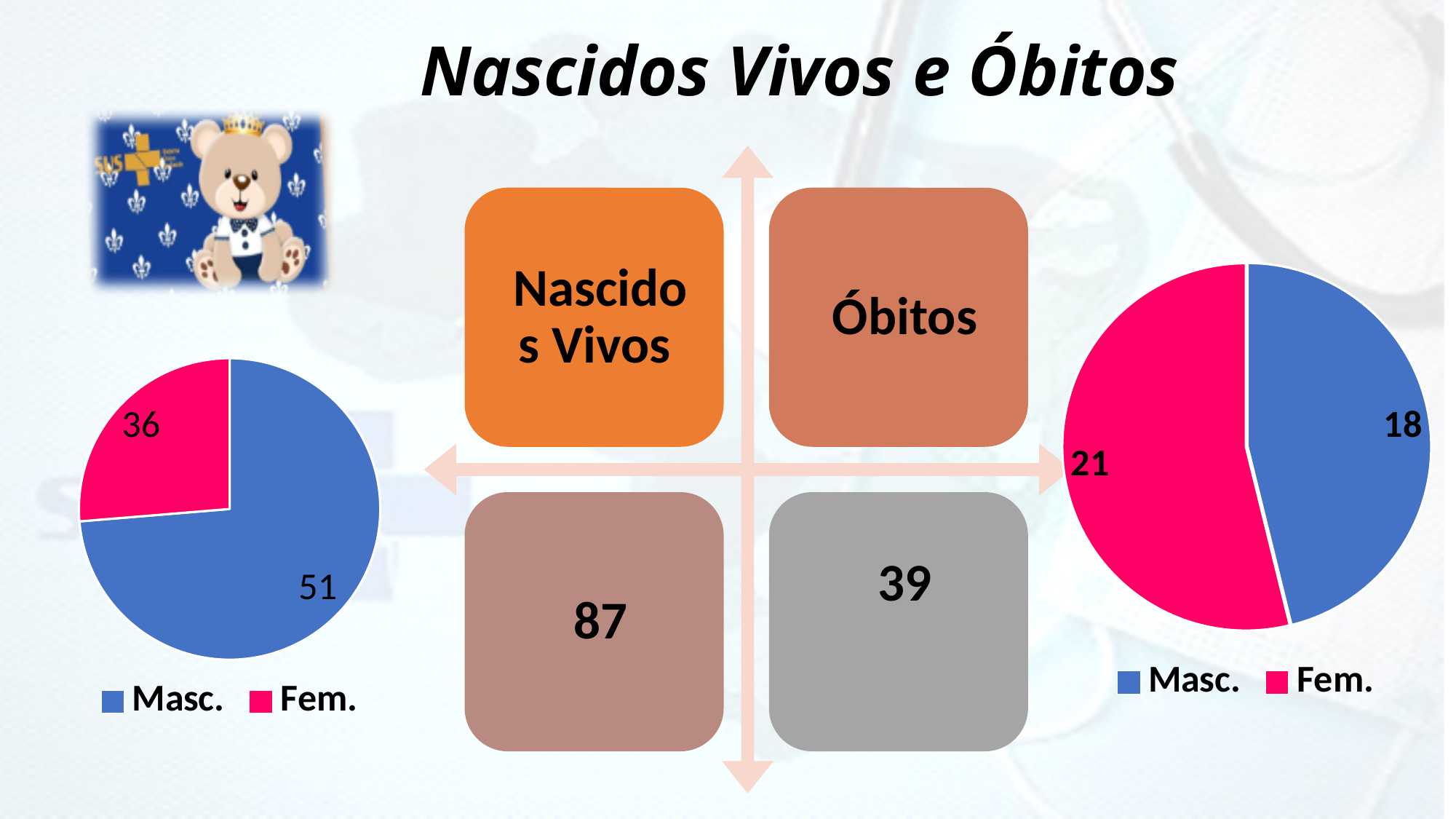
In the pie chart on the left of the slide, what is the value for Fem.? 36 What type of chart is shown on the left of the slide? Pie chart In the pie chart on the left of the slide, what is the difference between the Masc. and Fem. values? 15 In the pie chart on the left of the slide, what colour is the Fem. slice? Pink In the pie chart on the right of the slide, which category has the smallest slice? Masc. In the pie chart on the right of the slide, what is the difference between the Fem. and Masc. values? 3 In the pie chart on the left of the slide, what is the value for Masc.? 51 In the pie chart on the right of the slide, what is the value for Masc.? 18 In the pie chart on the left of the slide, which category has the largest slice? Masc. In the pie chart on the right of the slide, which is larger, Masc. or Fem.? Fem. How many entries does the legend of the pie chart on the right of the slide list? 2 In the pie chart on the right of the slide, what is the value for Fem.? 21